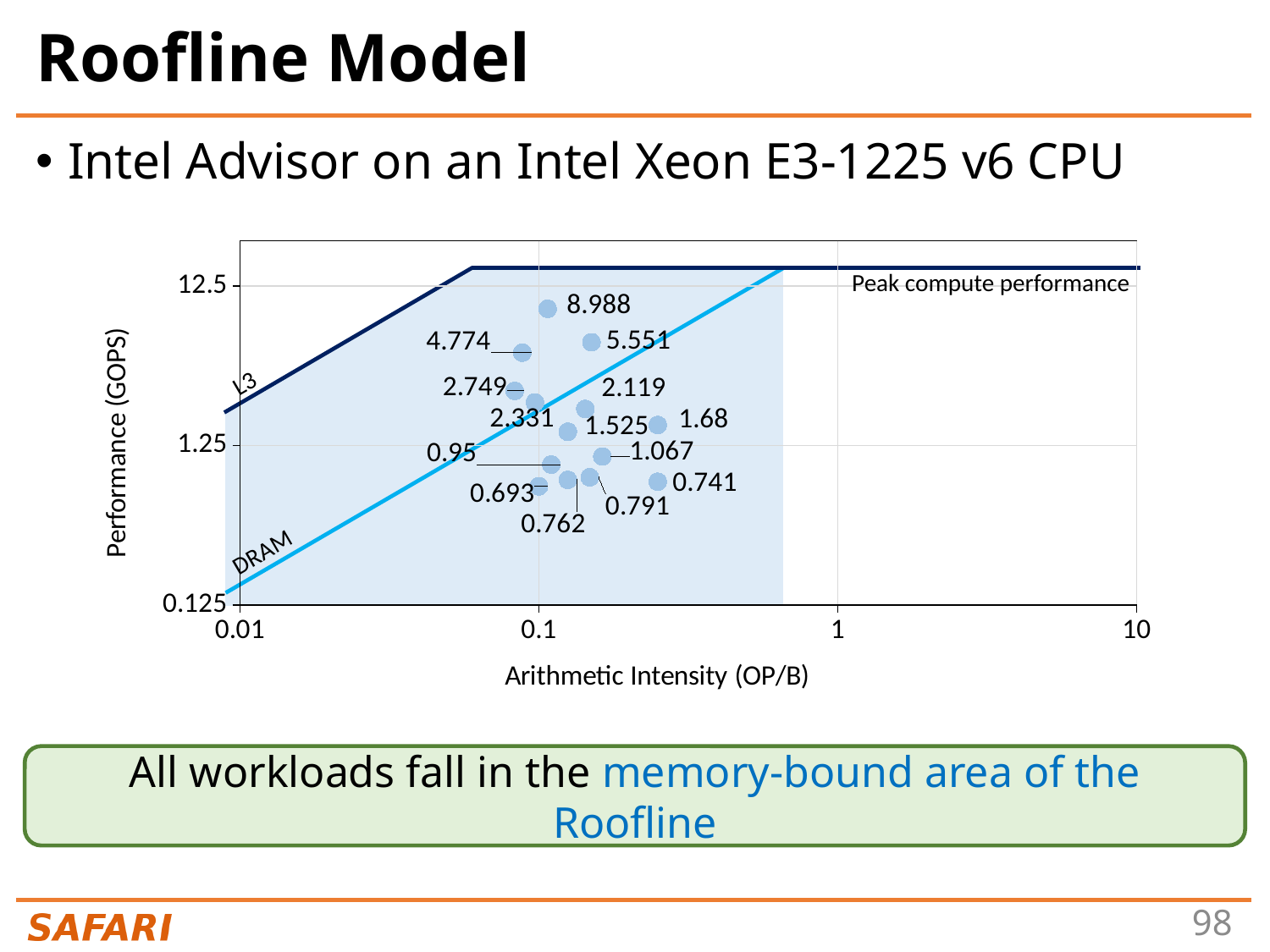
What is the label of the y axis? Performance (GOPS) Which labeled point has the larger value, 1.68 or 1.525? 1.68 What is the highest labeled performance value among the plotted workload points? 8.988 What is the label on the horizontal line at the top of the chart? Peak compute performance What is the difference between the labeled values 4.774 and 2.749? 2.025 What is the difference between the labeled values 1.067 and 0.95? 0.117 What is the label of the x axis? Arithmetic Intensity (OP/B) Which labeled point has the larger value, 0.791 or 0.741? 0.791 What kind of chart is shown on the slide? scatter chart What is the lowest labeled performance value among the plotted workload points? 0.693 Is the value of the highest plotted workload point greater or less than 12.5 GOPS? less What is the difference between the labeled values 8.988 and 5.551? 3.437